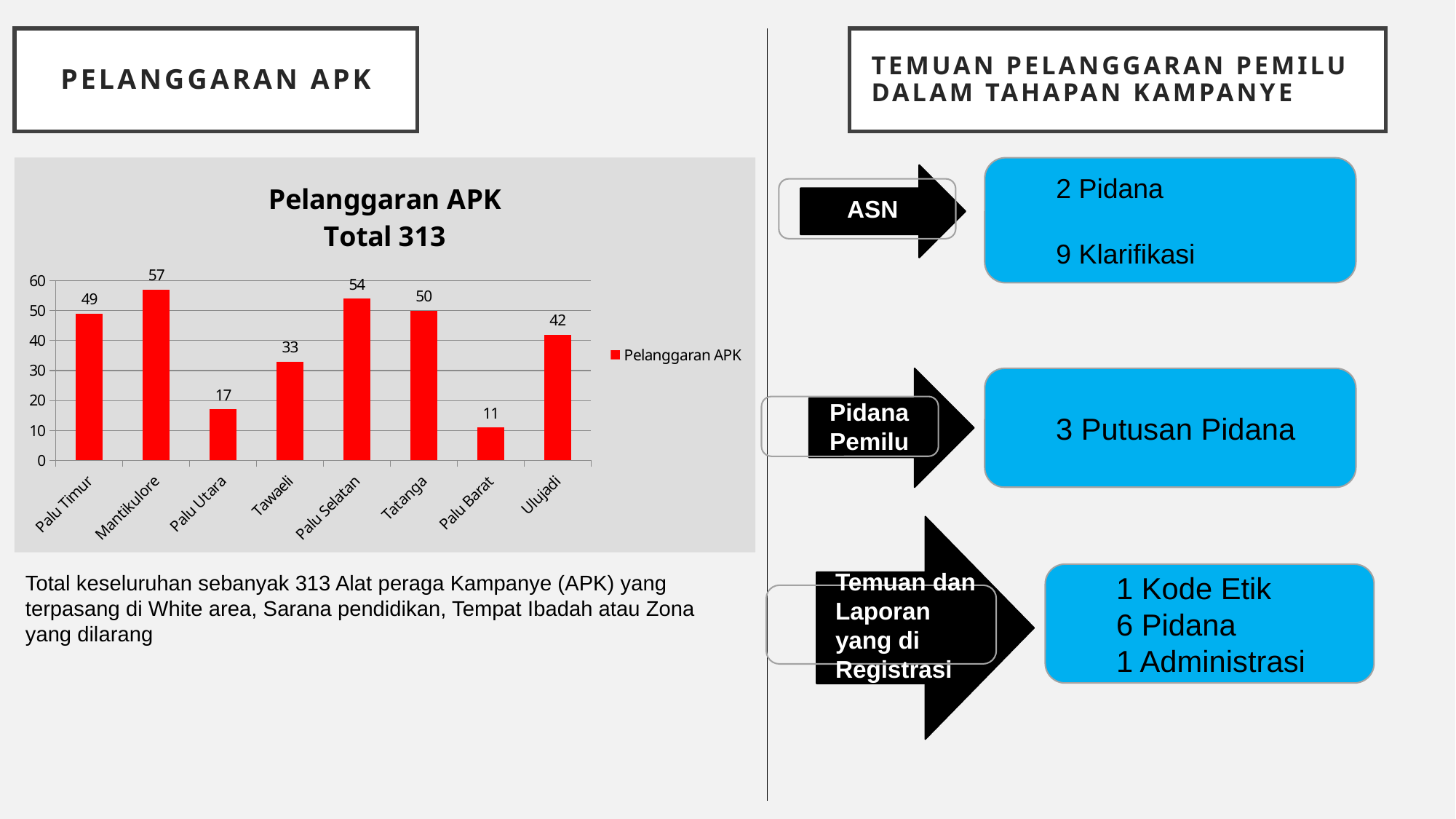
What total is stated in the title of the Pelanggaran APK chart? 313 Which category has the lowest value in the Pelanggaran APK chart? Palu Barat How many categories are shown in the Pelanggaran APK chart? 8 Which is larger in the Pelanggaran APK chart, Palu Timur or Ulujadi? Palu Timur What is the value for Tawaeli in the Pelanggaran APK chart? 33 How many series does the legend of the Pelanggaran APK chart list? 1 What is the difference between the values for Palu Selatan and Palu Utara in the Pelanggaran APK chart? 37 What is the value for Mantikulore in the Pelanggaran APK chart? 57 What kind of chart is the Pelanggaran APK chart? bar chart Which category has the highest value in the Pelanggaran APK chart? Mantikulore Is the value for Tatanga in the Pelanggaran APK chart greater or less than 40? greater What is the value for Palu Barat in the Pelanggaran APK chart? 11